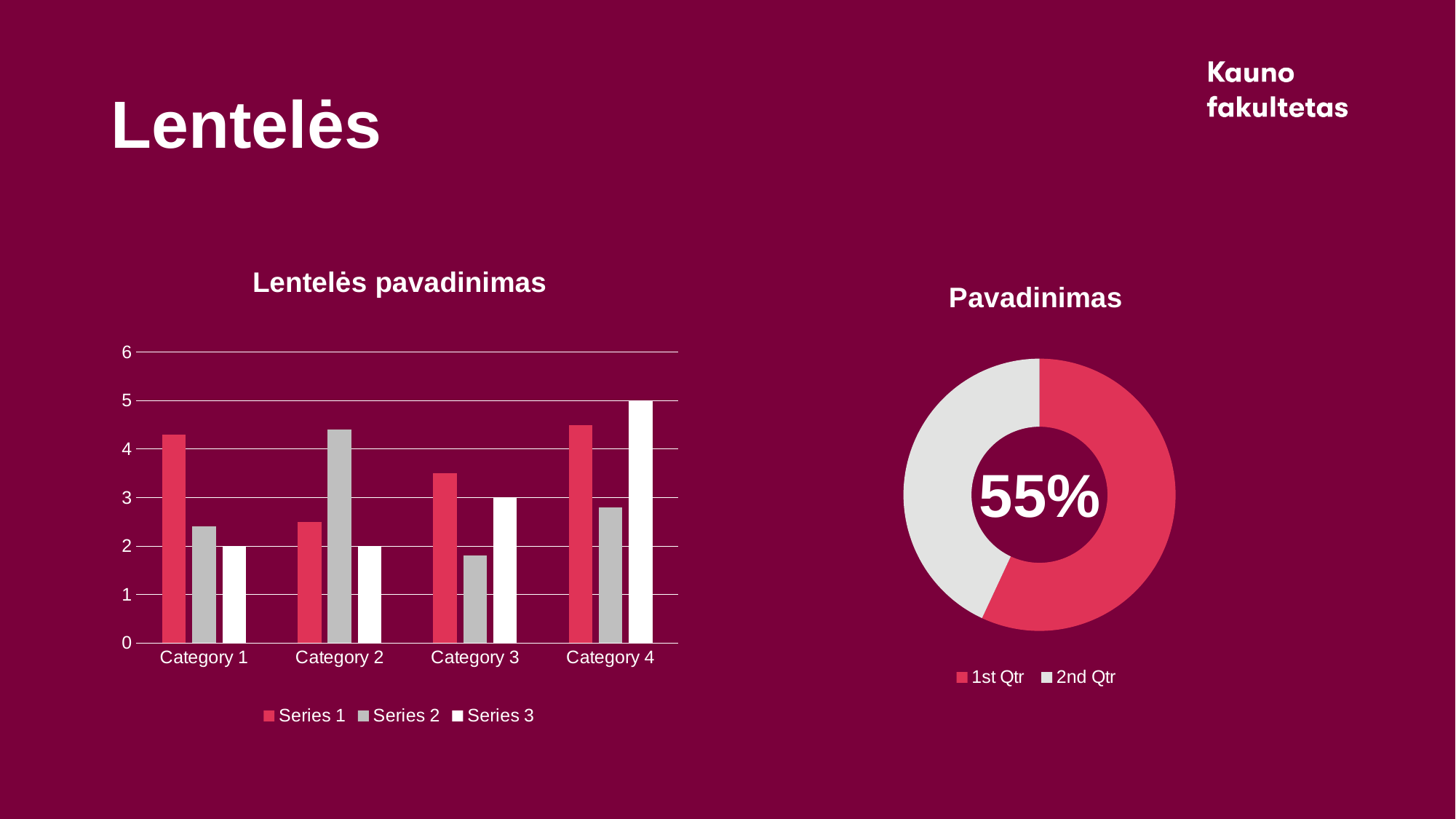
On the chart titled "Lentelės pavadinimas", for Category 2, which is larger: Series 1 or Series 2? Series 2 On the chart titled "Lentelės pavadinimas", in which category is Series 3 highest? Category 4 On the chart titled "Lentelės pavadinimas", what kind of chart is it? bar chart On the chart titled "Lentelės pavadinimas", how many series does the legend list? 3 On the chart titled "Lentelės pavadinimas", what is the value of Series 3 for Category 4? 5 On the chart titled "Lentelės pavadinimas", is the value of Series 2 for Category 3 greater or less than 2? less On the chart titled "Lentelės pavadinimas", is the value of Series 1 for Category 1 greater or less than 4? greater On the chart titled "Lentelės pavadinimas", what is the value of Series 3 for Category 3? 3 On the chart titled "Pavadinimas", what kind of chart is it? doughnut chart On the chart titled "Pavadinimas", what share does 1st Qtr have? 55% On the chart titled "Lentelės pavadinimas", how many categories are shown on the x axis? 4 On the chart titled "Lentelės pavadinimas", in which category is Series 2 lowest? Category 3